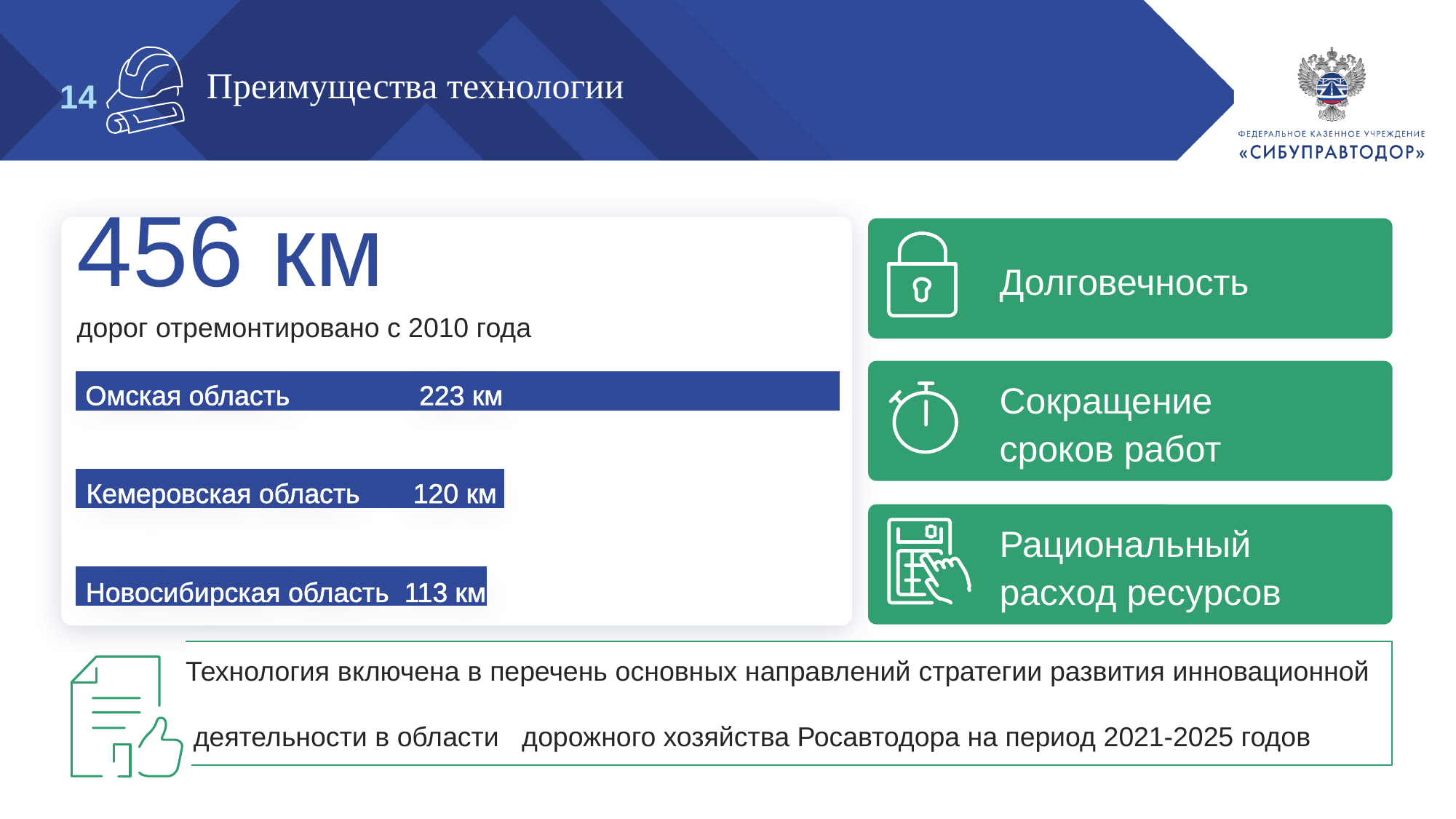
What is the difference in kilometres between Кемеровская область and Новосибирская область? 7 км How many kilometres of roads were repaired in Кемеровская область? 120 км Which has more kilometres of repaired roads, Омская область or Новосибирская область? Омская область What colour are the bars in the chart? blue What is the total number of kilometres of roads repaired since 2010 shown above the bar chart? 456 км Which region has the highest number of kilometres of repaired roads? Омская область How many kilometres of roads were repaired in Новосибирская область? 113 км How many kilometres of roads were repaired in Омская область? 223 км Which region has the lowest number of kilometres of repaired roads? Новосибирская область What is the difference in kilometres between Омская область and Кемеровская область? 103 км What kind of chart shows the kilometres of roads repaired by region? bar chart How many regions are shown in the bar chart? 3